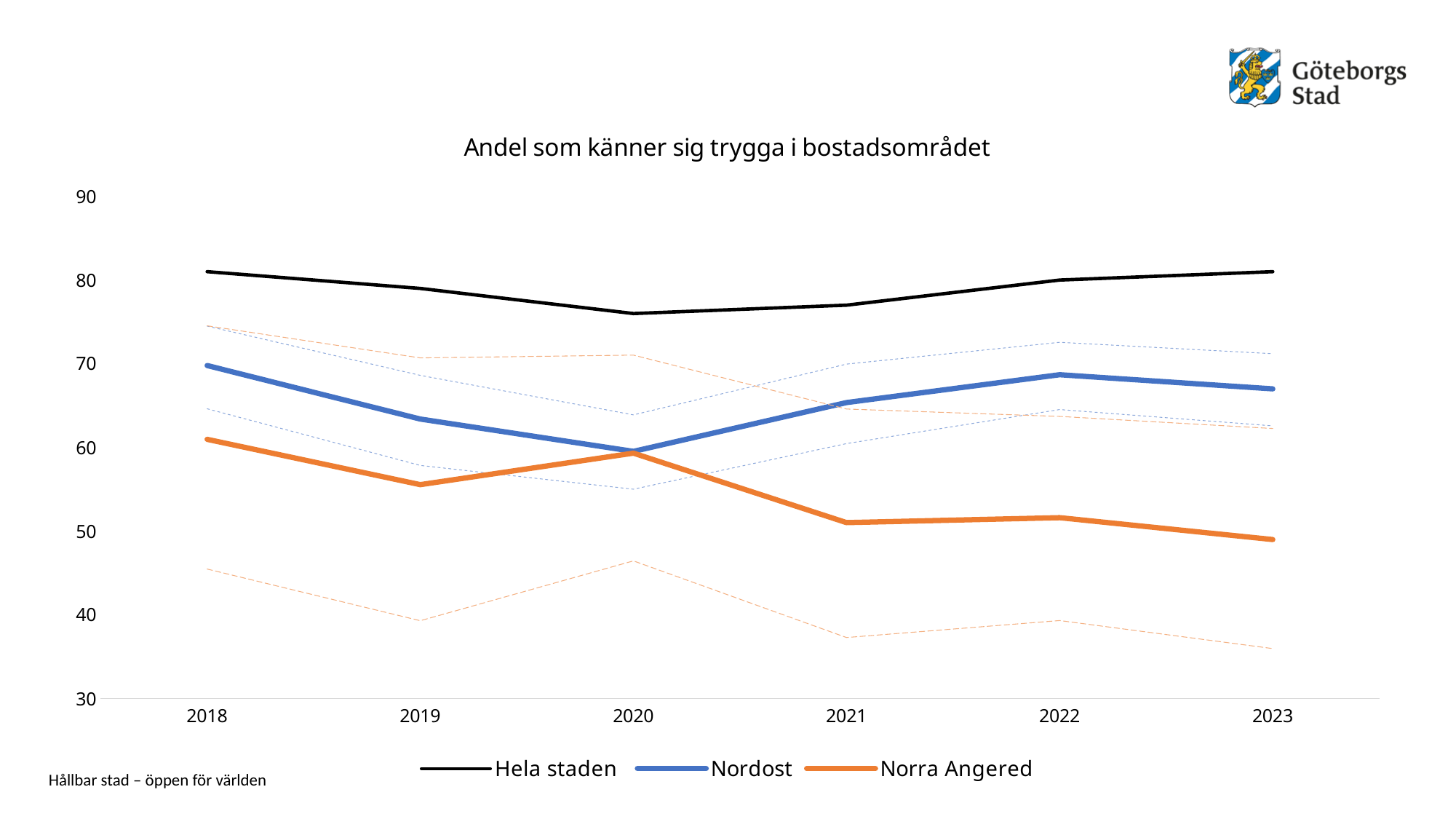
How many series does the legend list? 3 Which series is drawn in orange in the legend? Norra Angered In which year is Hela staden at its lowest? 2020 Which is larger in 2023, Nordost or Norra Angered? Nordost In which year is Norra Angered at its highest? 2018 Is the value for Norra Angered in 2023 greater or less than 50? less Does the Norra Angered line rise or fall from 2020 to 2023? fall Is the value for Hela staden in 2020 greater or less than 80? less What kind of chart is shown on the slide? line chart What is the title of the chart? Andel som känner sig trygga i bostadsområdet How many years are shown on the x axis? 6 Is the value for Norra Angered in 2019 greater or less than 60? less